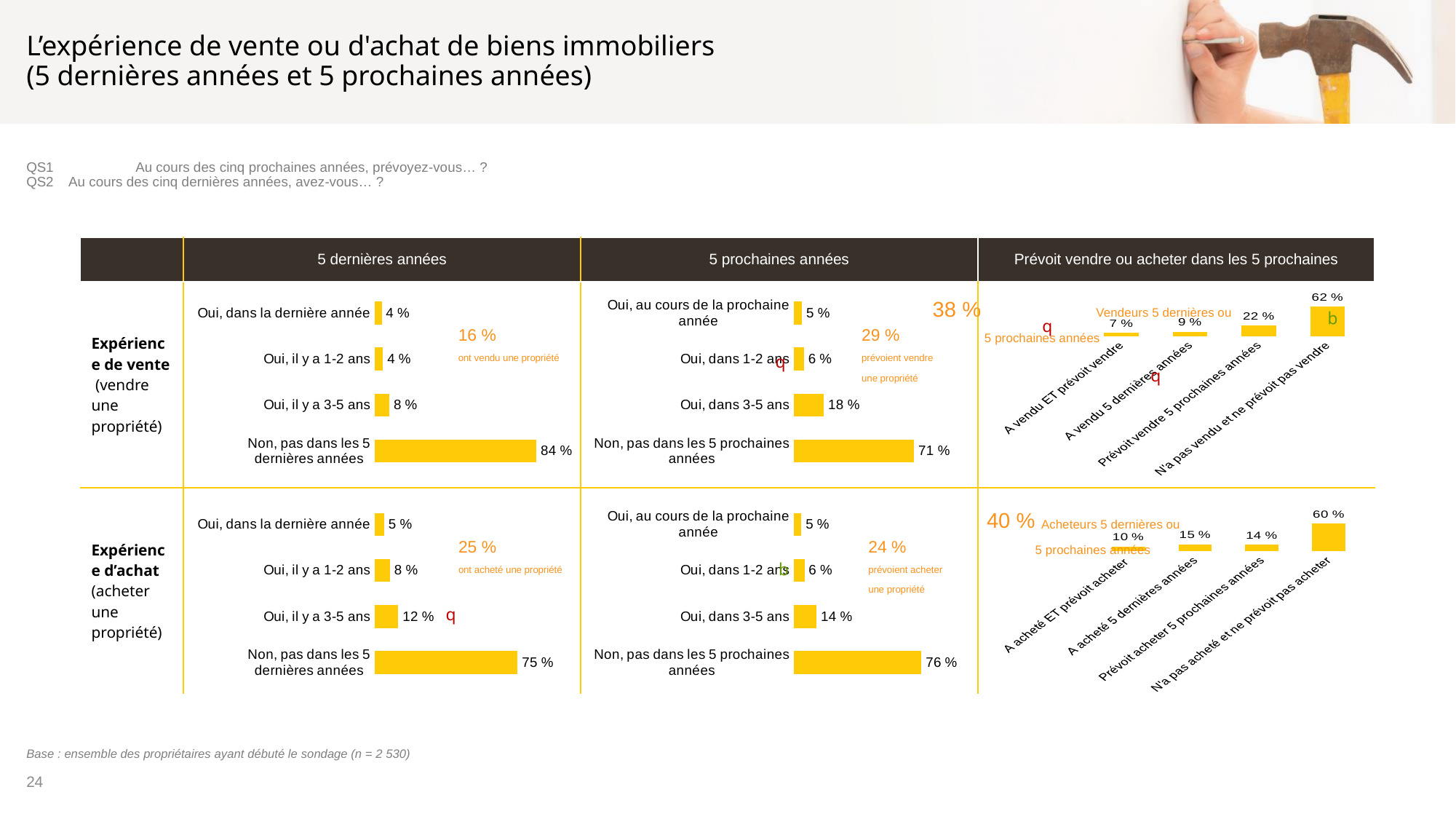
In the 'Expérience d'achat' row, '5 dernières années' chart, what is the value for 'Oui, il y a 3-5 ans'? 12 % In the 'Expérience d'achat' row, 'Prévoit vendre ou acheter dans les 5 prochaines' chart, what is the value for 'N'a pas acheté et ne prévoit pas acheter'? 60 % What colour are the bars in the charts on this slide? Yellow What kind of chart is used in the 'Expérience d'achat' row, '5 dernières années' cell? Bar chart In the 'Expérience de vente' row, 'Prévoit vendre ou acheter dans les 5 prochaines' chart, which category has the highest value? N'a pas vendu et ne prévoit pas vendre In the 'Expérience de vente' row, '5 dernières années' chart, what is the difference between 'Oui, il y a 3-5 ans' and 'Oui, il y a 1-2 ans'? 4 % In the 'Expérience d'achat' row, '5 prochaines années' chart, what is the difference between 'Non, pas dans les 5 prochaines années' and 'Oui, dans 3-5 ans'? 62 % In the 'Expérience de vente' row, '5 prochaines années' chart, what is the value for 'Oui, dans 3-5 ans'? 18 % In the 'Expérience d'achat' row, 'Prévoit vendre ou acheter dans les 5 prochaines' chart, which is larger: 'A acheté 5 dernières années' or 'Prévoit acheter 5 prochaines années'? A acheté 5 dernières années In the 'Expérience de vente' row, 'Prévoit vendre ou acheter dans les 5 prochaines' chart, which category has the lowest value? A vendu ET prévoit vendre How many categories are shown in the 'Expérience de vente' row, '5 prochaines années' chart? 4 In the 'Expérience de vente' row, '5 dernières années' chart, what is the value for 'Non, pas dans les 5 dernières années'? 84 %